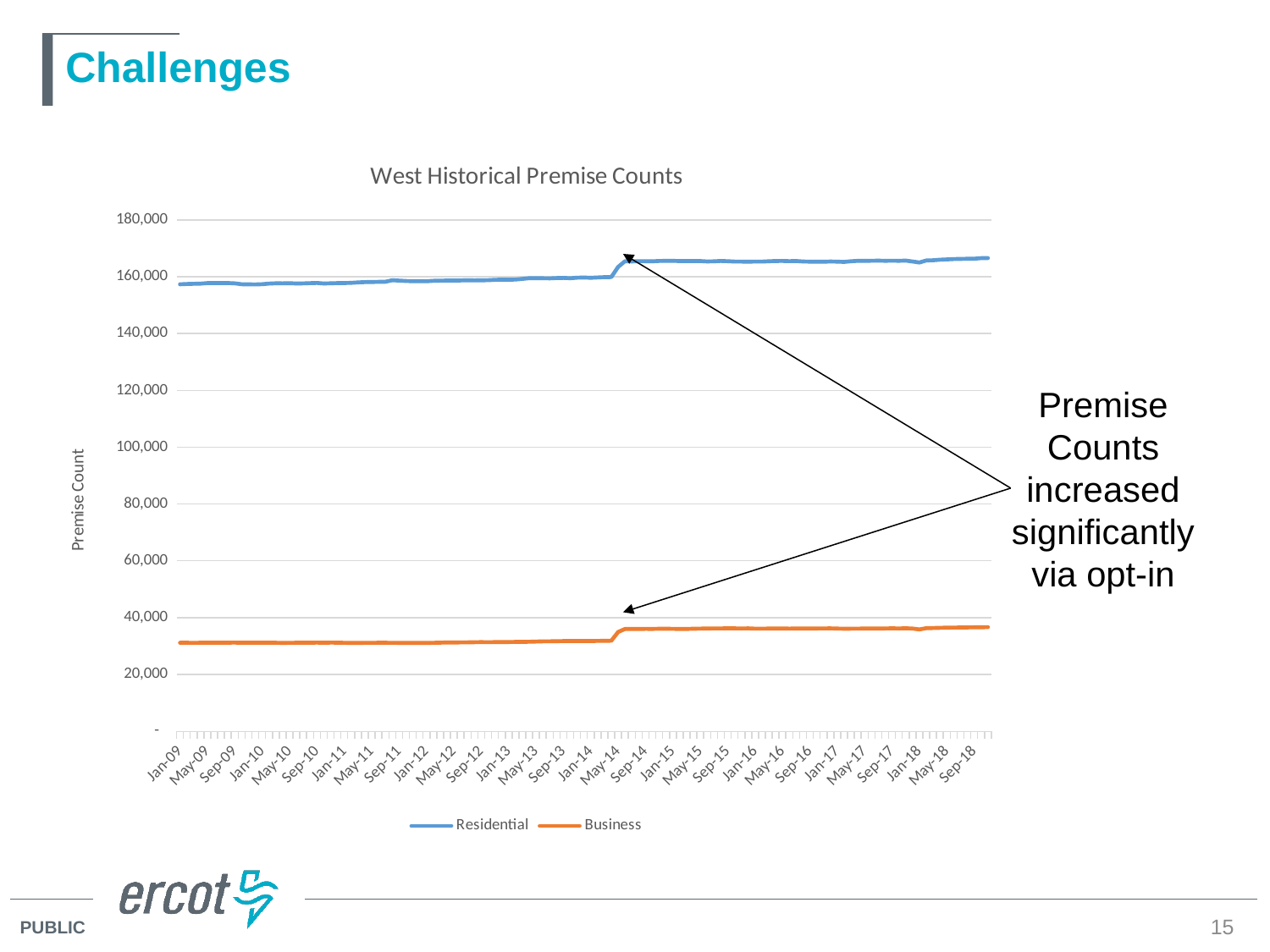
What kind of chart is shown on the slide? line chart Do the Business premise counts rise or fall from Jan-09 to Sep-18? rise Is the value for Residential in Jan-09 greater or less than 160,000? less Is the value for Residential in Jan-14 greater or less than 140,000? greater How many series does the legend list? 2 Which series has the higher premise counts throughout the chart, Residential or Business? Residential What is the title of the chart? West Historical Premise Counts Is the value for Business in Jan-09 greater or less than 20,000? greater What is the label on the vertical axis? Premise Count Do the Residential premise counts rise or fall from Jan-09 to Sep-18? rise